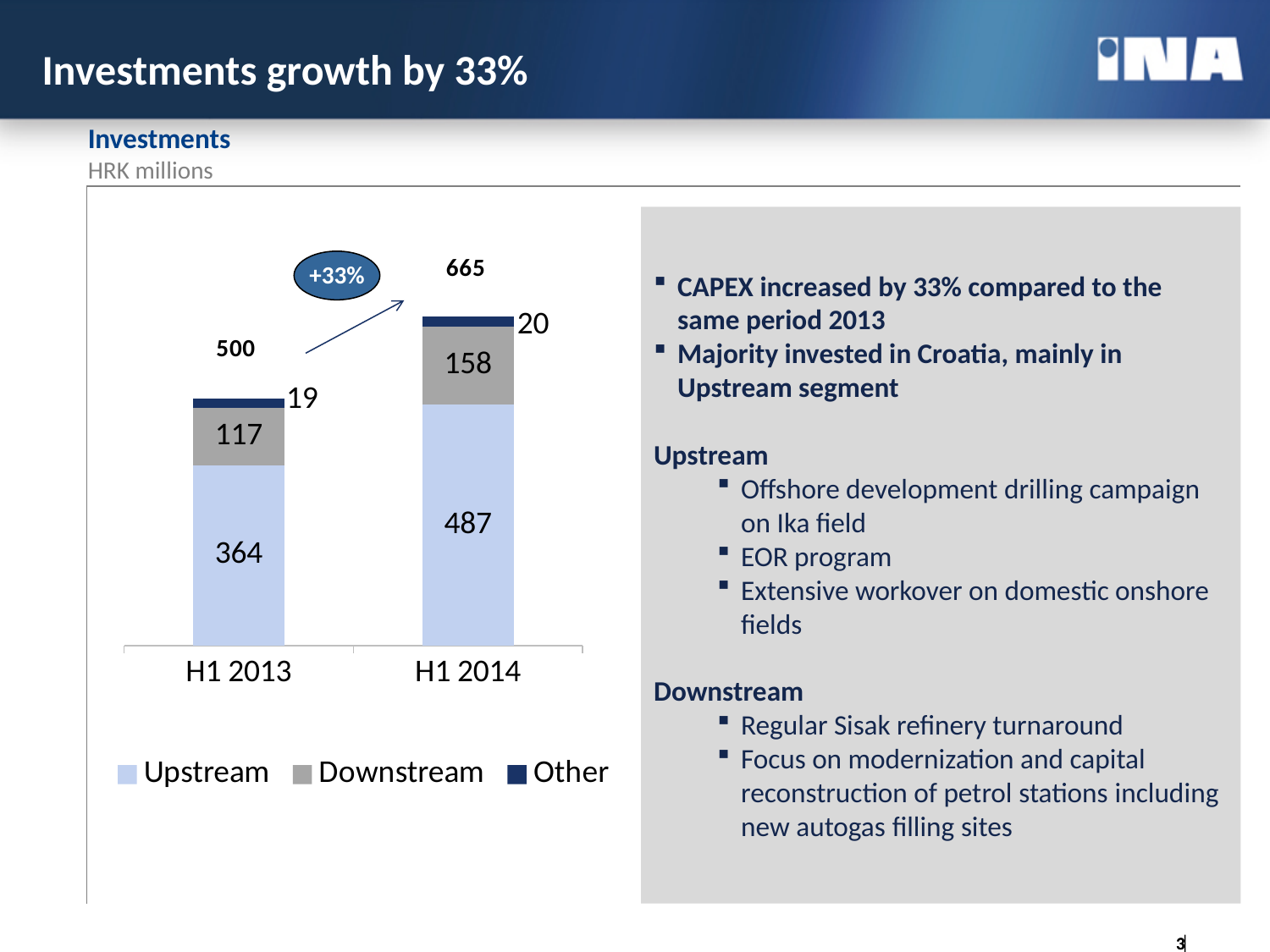
By how much did Upstream investment increase from H1 2013 to H1 2014? 123 What is the total investment shown for H1 2013? 500 What is the Upstream investment value for H1 2014? 487 Which period has the higher total investment, H1 2013 or H1 2014? H1 2014 What is the Other investment value for H1 2014? 20 Which segment has the lowest investment in H1 2013? Other What is the Downstream investment value for H1 2013? 117 What is the difference between Downstream investment in H1 2014 and H1 2013? 41 What is the total investment shown for H1 2014? 665 How many series does the legend list? 3 What percentage growth is shown in the oval annotation on the chart? +33% What type of chart is shown on the slide? Stacked bar chart